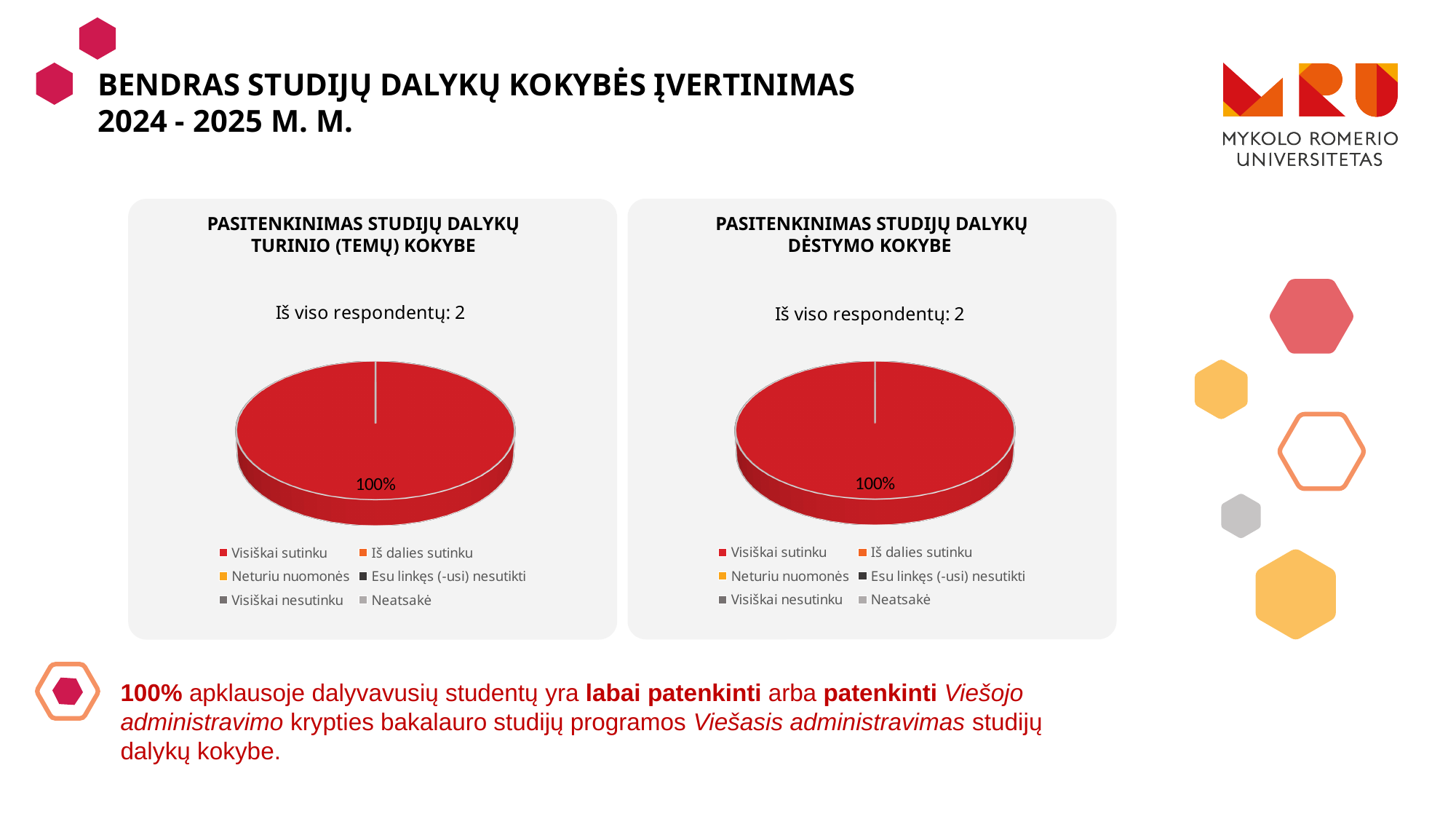
In the right chart, "Pasitenkinimas studijų dalykų dėstymo kokybe", which category has the largest slice? Visiškai sutinku In the left chart, "Pasitenkinimas studijų dalykų turinio (temų) kokybe", which category has the largest slice? Visiškai sutinku In the right chart, "Pasitenkinimas studijų dalykų dėstymo kokybe", how many slices are visible in the pie? 1 In the left chart titled "Pasitenkinimas studijų dalykų turinio (temų) kokybe", what share of the pie does "Visiškai sutinku" take? 100% How many entries does the legend of the right chart, "Pasitenkinimas studijų dalykų dėstymo kokybe", list? 6 What kind of chart is the left chart, "Pasitenkinimas studijų dalykų turinio (temų) kokybe"? Pie chart How many entries does the legend of the left chart, "Pasitenkinimas studijų dalykų turinio (temų) kokybe", list? 6 In the left chart, "Pasitenkinimas studijų dalykų turinio (temų) kokybe", how many slices are visible in the pie? 1 In the right chart titled "Pasitenkinimas studijų dalykų dėstymo kokybe", what share of the pie does "Visiškai sutinku" take? 100% How many respondents in total are reported for the right chart, "Pasitenkinimas studijų dalykų dėstymo kokybe"? 2 What kind of chart is the right chart, "Pasitenkinimas studijų dalykų dėstymo kokybe"? Pie chart How many respondents in total are reported for the left chart, "Pasitenkinimas studijų dalykų turinio (temų) kokybe"? 2